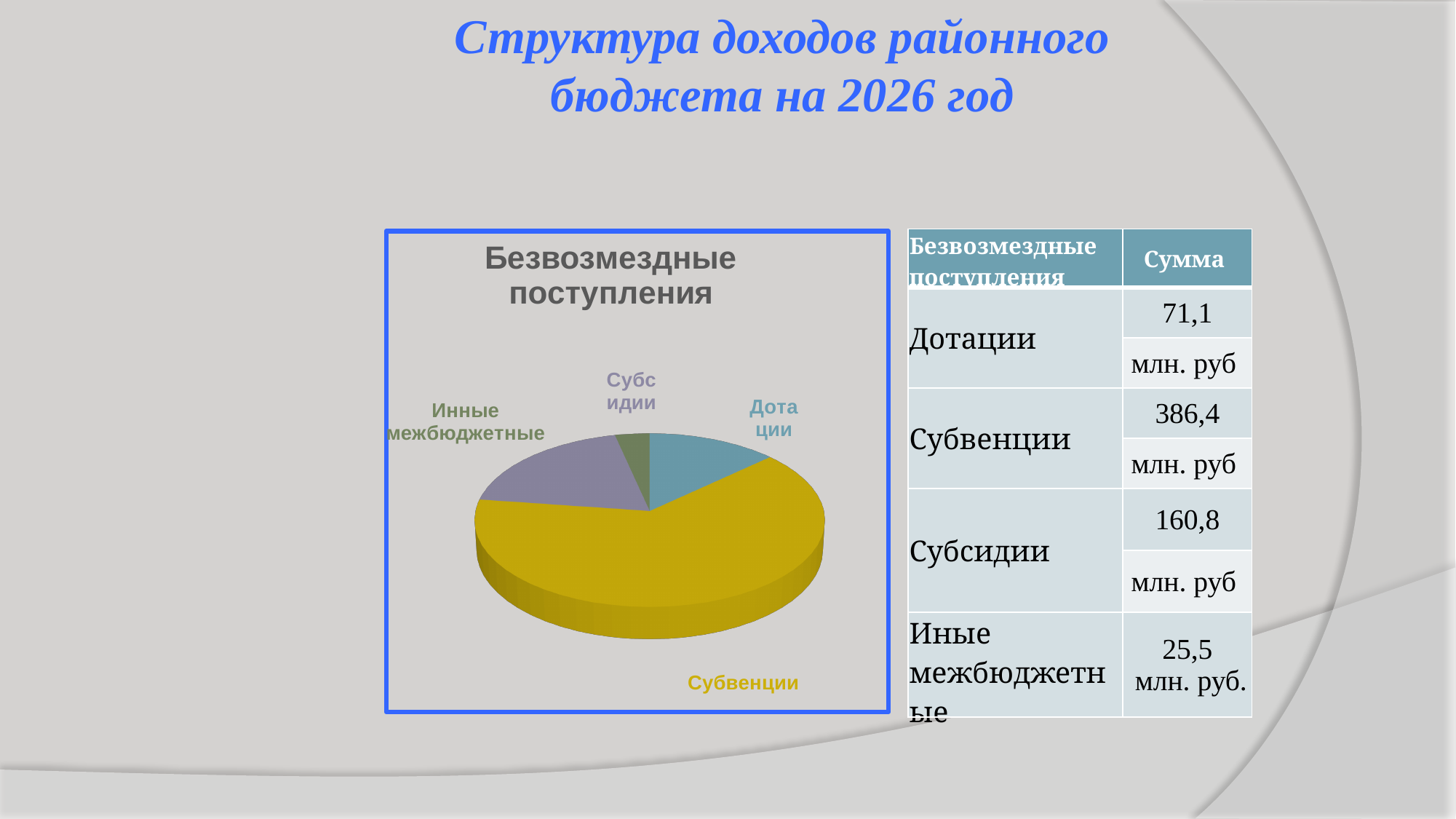
According to the table next to the pie chart, what is the value for Субсидии? 160,8 млн. руб According to the table next to the pie chart, what is the value for Дотации? 71,1 млн. руб Which category has the largest slice in the pie chart? Субвенции What kind of chart is shown on the slide? Pie chart According to the table next to the pie chart, what is the value for Субвенции? 386,4 млн. руб Which is larger in the pie chart, Субвенции or Дотации? Субвенции What colour is the Субвенции slice in the pie chart? Yellow What is the title of the pie chart? Безвозмездные поступления According to the table next to the pie chart, what is the value for Иные межбюджетные? 25,5 млн. руб. Which category has the smallest value according to the table next to the pie chart? Иные межбюджетные What is the difference between the values for Субвенции and Дотации shown in the table? 315,3 млн. руб How many slices does the pie chart have? 4